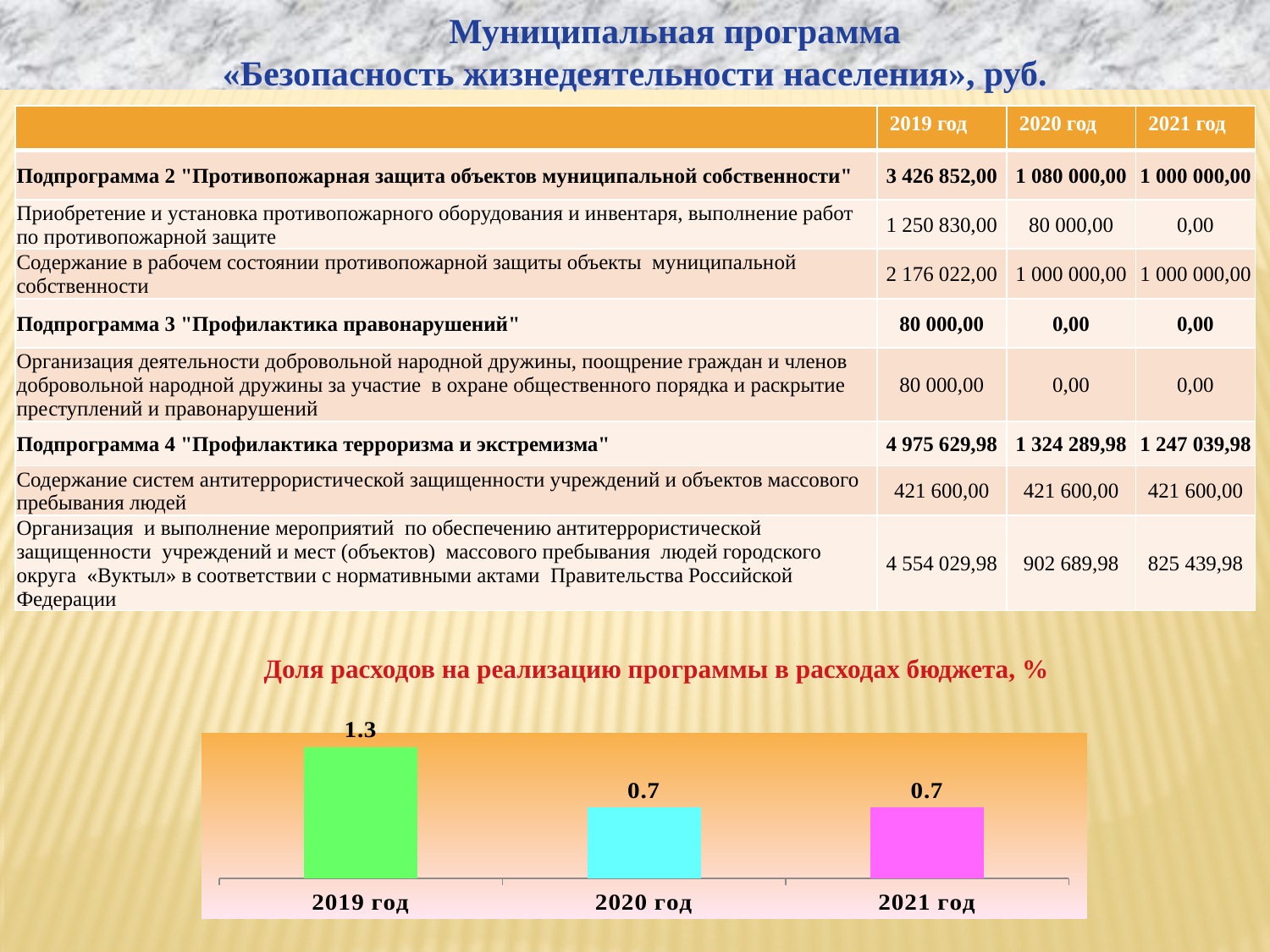
What is the value for 2021 год in the chart? 0.7 What colour is the bar for 2019 год? green What kind of chart is shown on the slide? bar chart Do the values rise or fall from 2019 год to 2021 год? fall Which is larger, the value for 2019 год or the value for 2021 год? 2019 год How many categories are shown on the x axis of the chart? 3 What is the difference between the values for 2019 год and 2020 год? 0.6 What is the title of the chart? Доля расходов на реализацию программы в расходах бюджета, % Is the value for 2020 год equal to the value for 2021 год? yes Which year has the highest value in the chart? 2019 год What is the value for 2019 год in the chart 'Доля расходов на реализацию программы в расходах бюджета, %'? 1.3 What is the value for 2020 год in the chart? 0.7